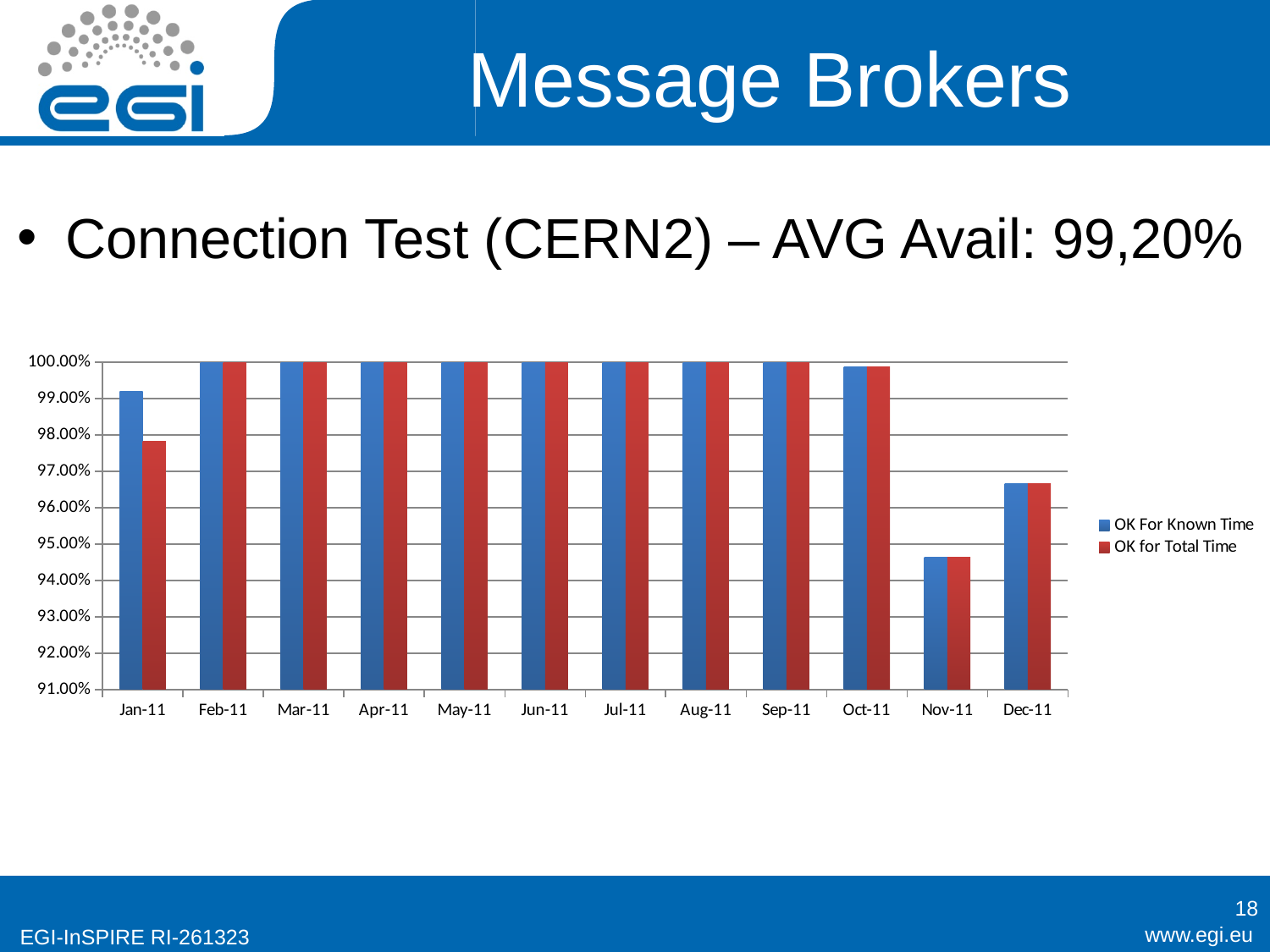
How many series does the chart legend list? 2 What kind of chart is shown on the slide? bar chart How many months are shown on the x axis of the chart? 12 What is the OK for Total Time value for Mar-11? 100.00% What are the two series named in the chart legend? OK For Known Time, OK for Total Time What is the OK For Known Time value for Jun-11? 100.00% Which month has the lowest OK For Known Time value? Nov-11 Which colour represents the OK for Total Time series? red Is the OK for Total Time value for Nov-11 greater or less than 95.00%? less Is the OK For Known Time value for Dec-11 greater or less than 96.00%? greater For Jan-11, which is larger: OK For Known Time or OK for Total Time? OK For Known Time Is the OK for Total Time value for Jan-11 greater or less than 98.00%? less